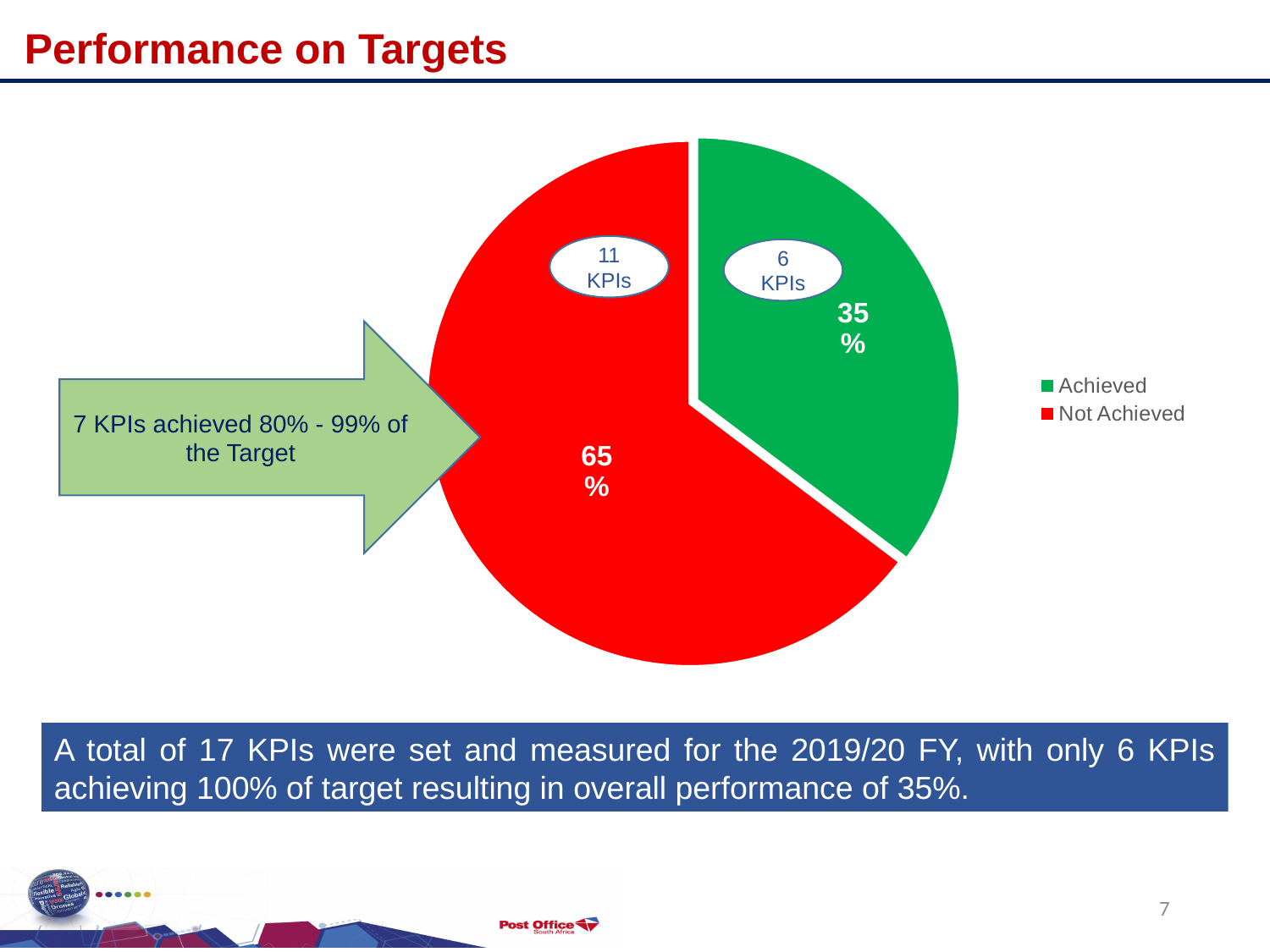
What colour is the Achieved slice? green What colour is the Not Achieved slice? red What is the difference in percentage points between the Not Achieved and Achieved slices? 30 How many categories does the legend list? 2 How many slices does the pie chart have? 2 Which slice of the pie is larger, Achieved or Not Achieved? Not Achieved How many KPIs are shown in the Not Achieved slice? 11 KPIs What kind of chart is shown on the slide? pie chart Which category has the smallest share of the pie? Achieved How many KPIs are shown in the Achieved slice? 6 KPIs What percentage of the pie is labelled Achieved? 35% What percentage of the pie is labelled Not Achieved? 65%